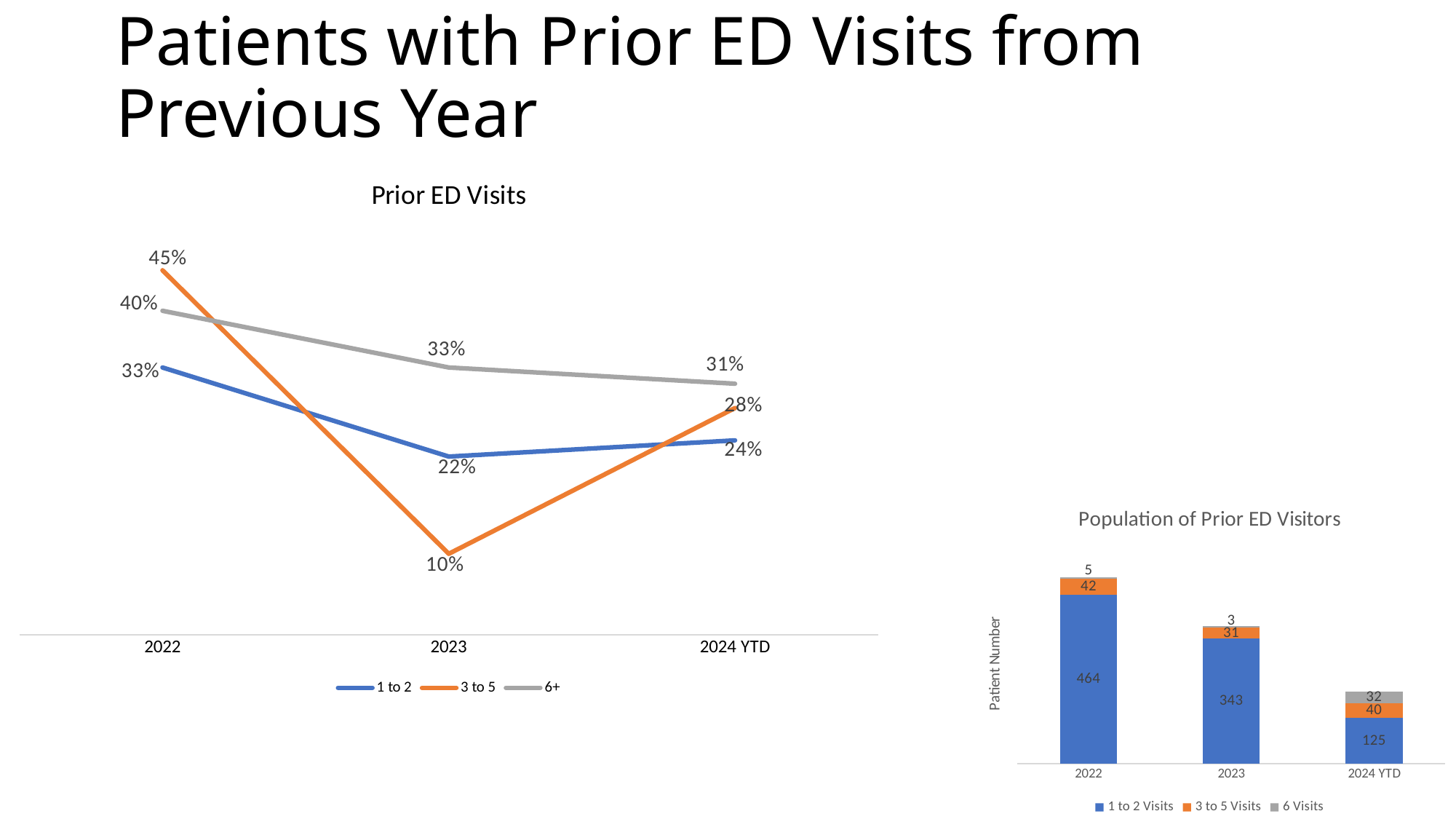
In the 'Prior ED Visits' chart, what is the value for the '6+' series in 2024 YTD? 31% What kind of chart is 'Population of Prior ED Visitors'? stacked bar chart In the 'Prior ED Visits' chart, how many series does the legend list? 3 In the 'Population of Prior ED Visitors' chart, which year has the lowest '1 to 2 Visits' value? 2024 YTD What kind of chart is 'Prior ED Visits'? line chart In the 'Prior ED Visits' chart, does the '6+' series rise or fall from 2022 to 2024 YTD? fall In the 'Population of Prior ED Visitors' chart, what is the total of the stacked bar for 2022? 511 In the 'Prior ED Visits' chart, which series has the highest value in 2022? 3 to 5 In the 'Prior ED Visits' chart, what is the difference between the '3 to 5' values in 2022 and 2023? 35% In the 'Prior ED Visits' chart, what is the value for the '3 to 5' series in 2023? 10% In the 'Population of Prior ED Visitors' chart, what is the value for '1 to 2 Visits' in 2023? 343 In the 'Population of Prior ED Visitors' chart, is the '6 Visits' value larger in 2024 YTD or in 2022? 2024 YTD